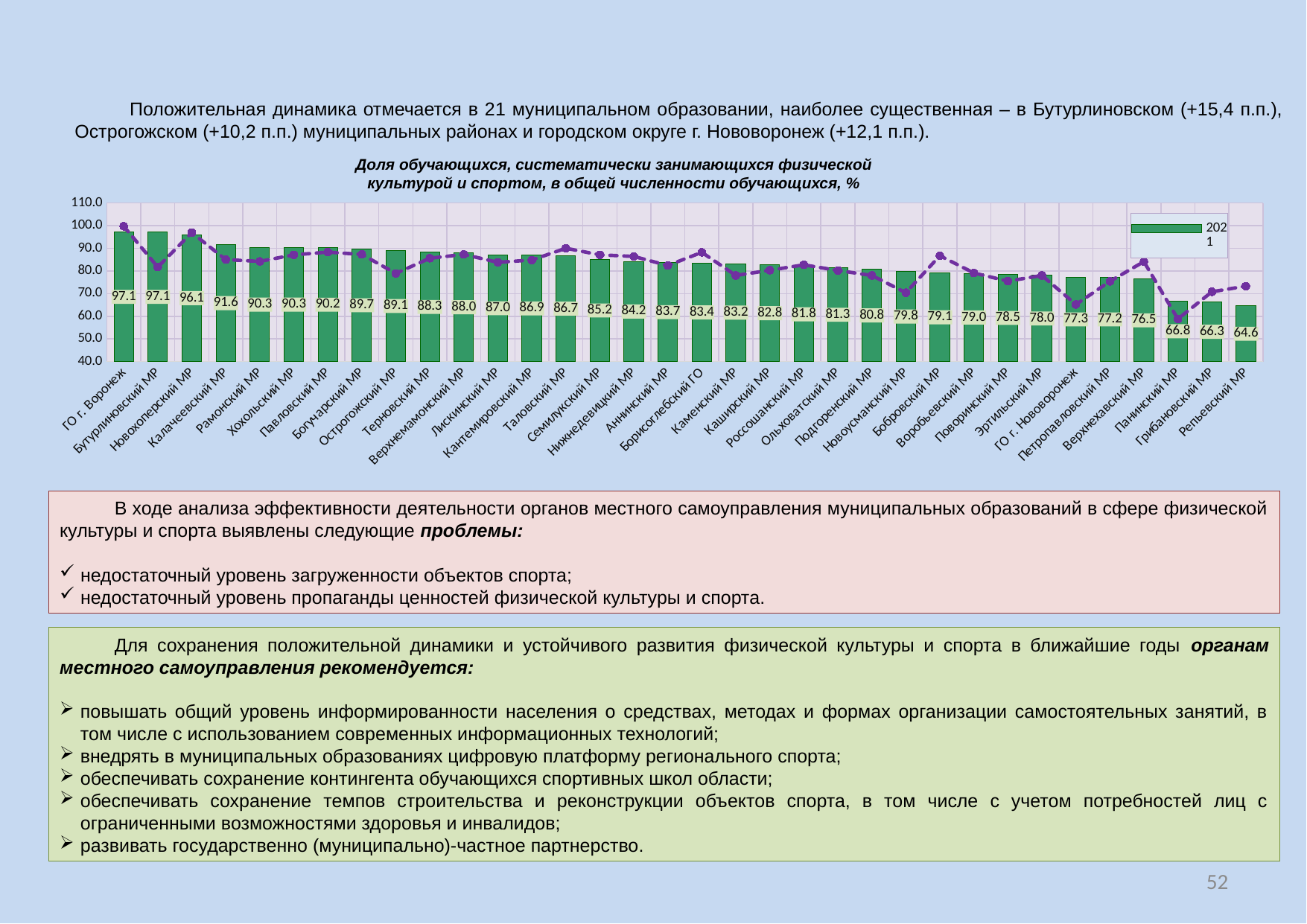
What is the difference between the 2021 values for Калачеевский МР and Репьевский МР? 27.0 What kind of chart is this? combination bar and line chart What is the title of the chart? Доля обучающихся, систематически занимающихся физической культурой и спортом, в общей численности обучающихся, % What is the 2021 value for Острогожский МР? 89.1 What is the 2021 value for ГО г. Нововоронеж? 77.3 How many municipalities are shown on the x axis? 34 What is the 2021 value for Грибановский МР? 66.3 Is the 2021 value for Панинский МР greater or less than 70.0? less Do the 2021 bar values rise or fall from left to right along the x axis? fall Which has a higher 2021 value, Лискинский МР or Каширский МР? Лискинский МР Which municipality has the lowest 2021 value? Репьевский МР What is the 2021 value for Калачеевский МР? 91.6